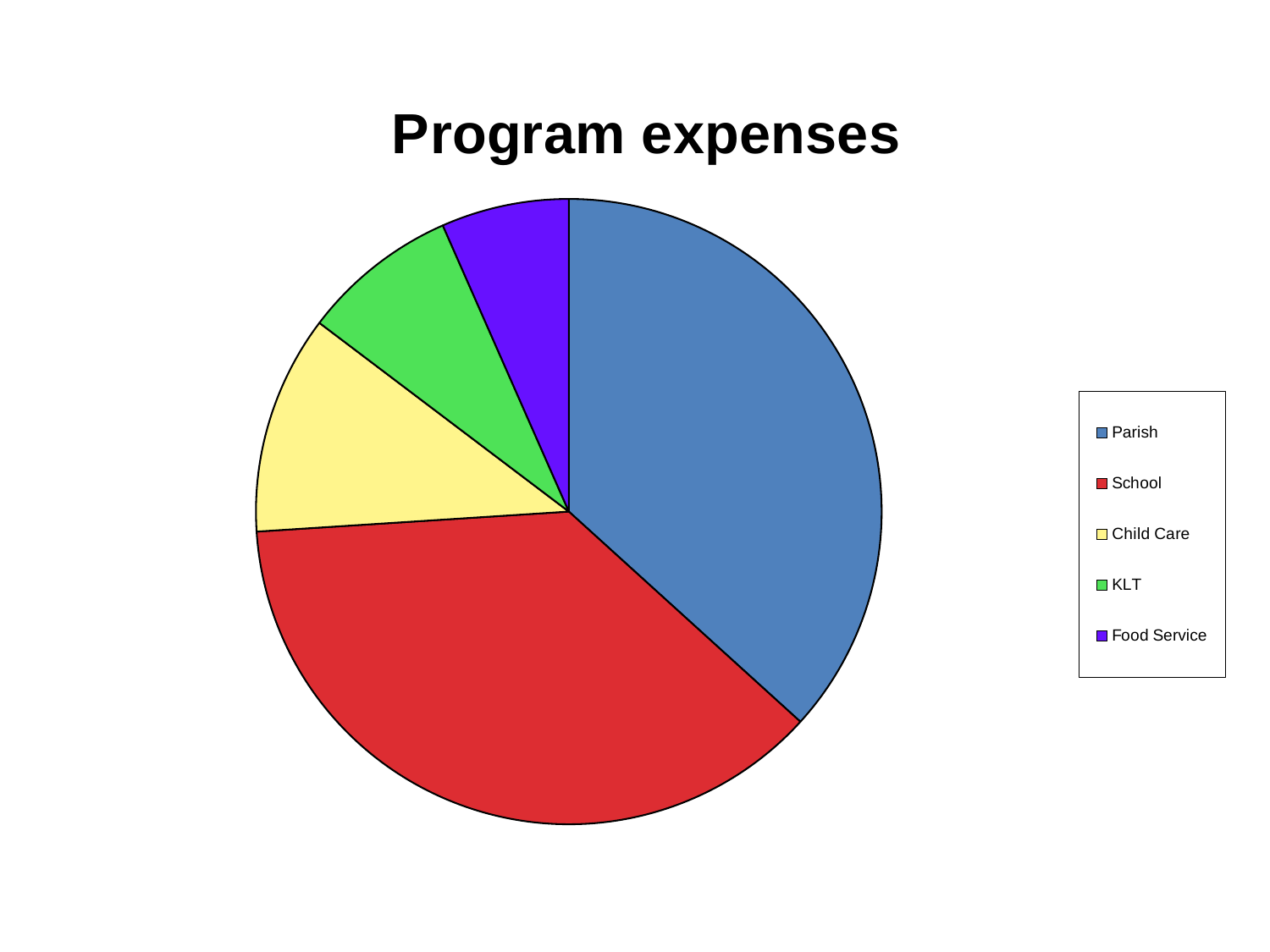
Which slice is larger, Parish or Child Care? Parish Which slice is larger, Child Care or Food Service? Child Care Which category has the smallest slice of the pie? Food Service Which slice is larger, School or KLT? School What is the title of the chart? Program expenses Which colour represents School in the pie chart? red Which category is listed first in the legend? Parish What kind of chart is shown on the slide? pie chart How many categories does the pie chart show? 5